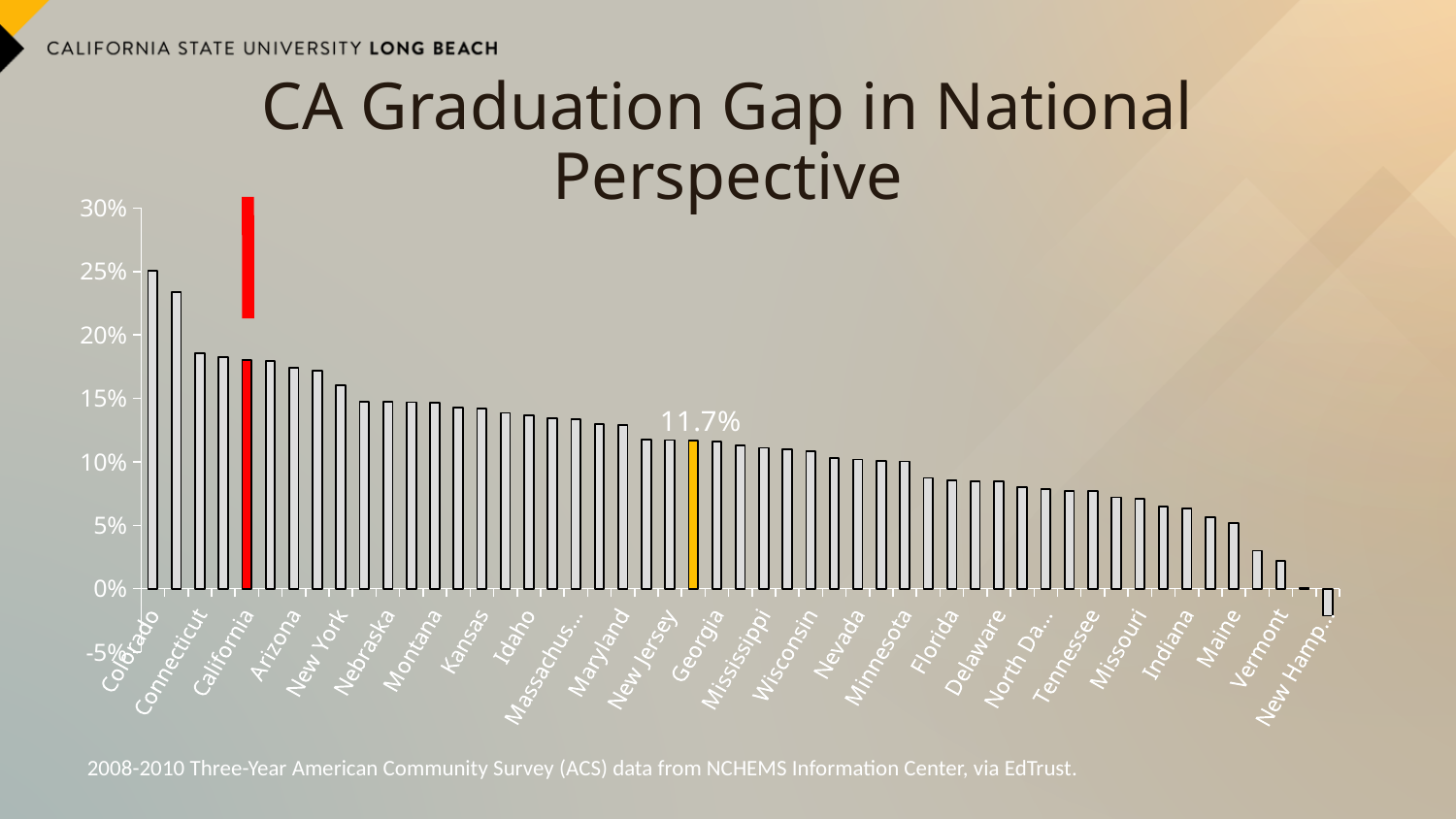
Is the value for Colorado greater or less than 20%? greater Is the value for Vermont greater or less than 5%? less What colour is the bar for California? red What value is printed as a data label on the gold bar? 11.7% Do the bar values generally rise or fall from left to right along the x axis? fall What kind of chart is shown on the slide? bar chart Which has a larger value, Colorado or California? Colorado Is the value for California greater or less than 20%? less Which has a larger value, California or Georgia? California Which state has the highest value in the chart? Colorado